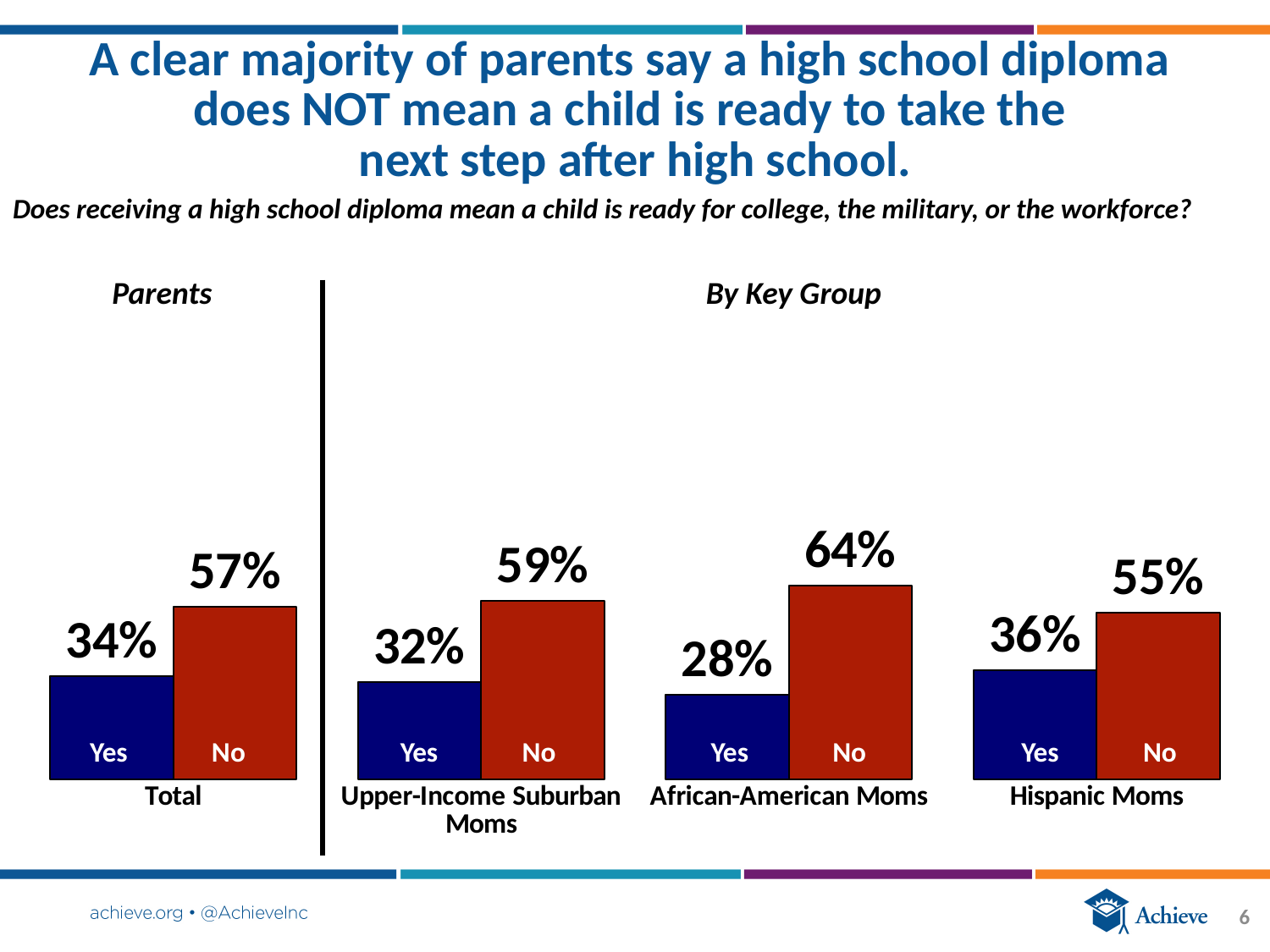
How many groups are shown in the By Key Group chart? 3 What type of chart is used on this slide? bar chart In the By Key Group chart, what is the difference between the No and Yes percentages for Hispanic Moms? 19% In the Parents chart, what is the difference between the No and Yes percentages? 23% In the By Key Group chart, which group has the lowest Yes percentage? African-American Moms In the Parents chart, what percentage of parents answered No? 57% In the By Key Group chart, which group has the highest No percentage? African-American Moms In the By Key Group chart, what percentage of Upper-Income Suburban Moms answered Yes? 32% In the By Key Group chart, what percentage of Hispanic Moms answered Yes? 36% In the By Key Group chart, what percentage of African-American Moms answered No? 64% In the By Key Group chart, is the Yes percentage for Hispanic Moms larger or smaller than the Yes percentage for Upper-Income Suburban Moms? larger In the Parents chart, what percentage of parents answered Yes? 34%